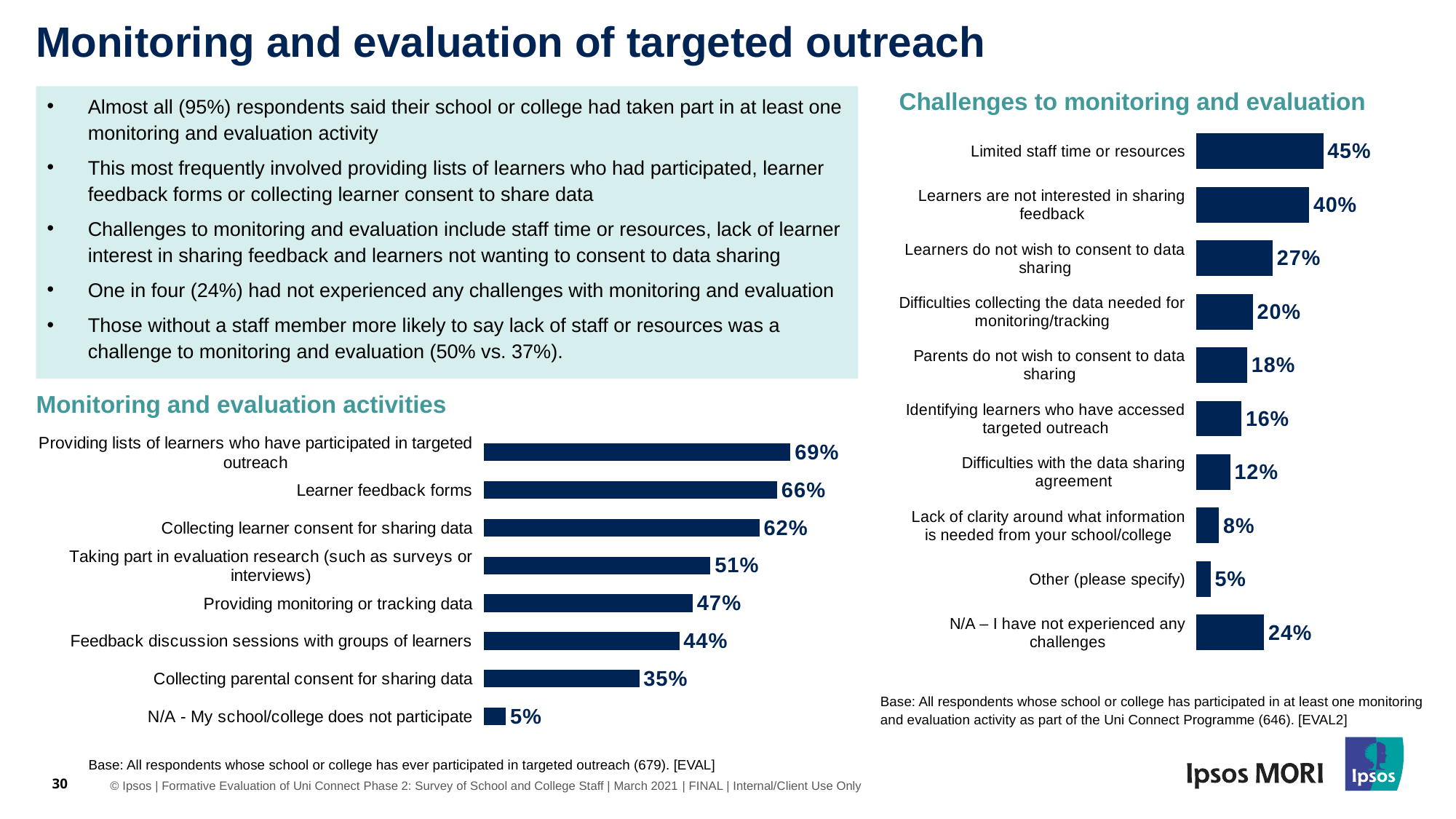
In the 'Monitoring and evaluation activities' chart, how many categories are shown? 8 In the 'Monitoring and evaluation activities' chart, which category has the highest value? Providing lists of learners who have participated in targeted outreach In the 'Challenges to monitoring and evaluation' chart, which category has the lowest value? Other (please specify) In the 'Challenges to monitoring and evaluation' chart, what is the difference between 'Limited staff time or resources' and 'Learners are not interested in sharing feedback'? 5 percentage points What is the title of the chart on the lower left of the slide? Monitoring and evaluation activities In the 'Monitoring and evaluation activities' chart, what is the value for 'Learner feedback forms'? 66% In the 'Monitoring and evaluation activities' chart, which is larger: 'Providing monitoring or tracking data' or 'Feedback discussion sessions with groups of learners'? Providing monitoring or tracking data In the 'Challenges to monitoring and evaluation' chart, what is the value for 'N/A – I have not experienced any challenges'? 24% In the 'Challenges to monitoring and evaluation' chart, what is the value for 'Learners do not wish to consent to data sharing'? 27% In the 'Challenges to monitoring and evaluation' chart, how many categories are shown? 10 What kind of chart is the 'Challenges to monitoring and evaluation' chart? Bar chart In the 'Monitoring and evaluation activities' chart, what is the difference between 'Collecting learner consent for sharing data' and 'Collecting parental consent for sharing data'? 27 percentage points